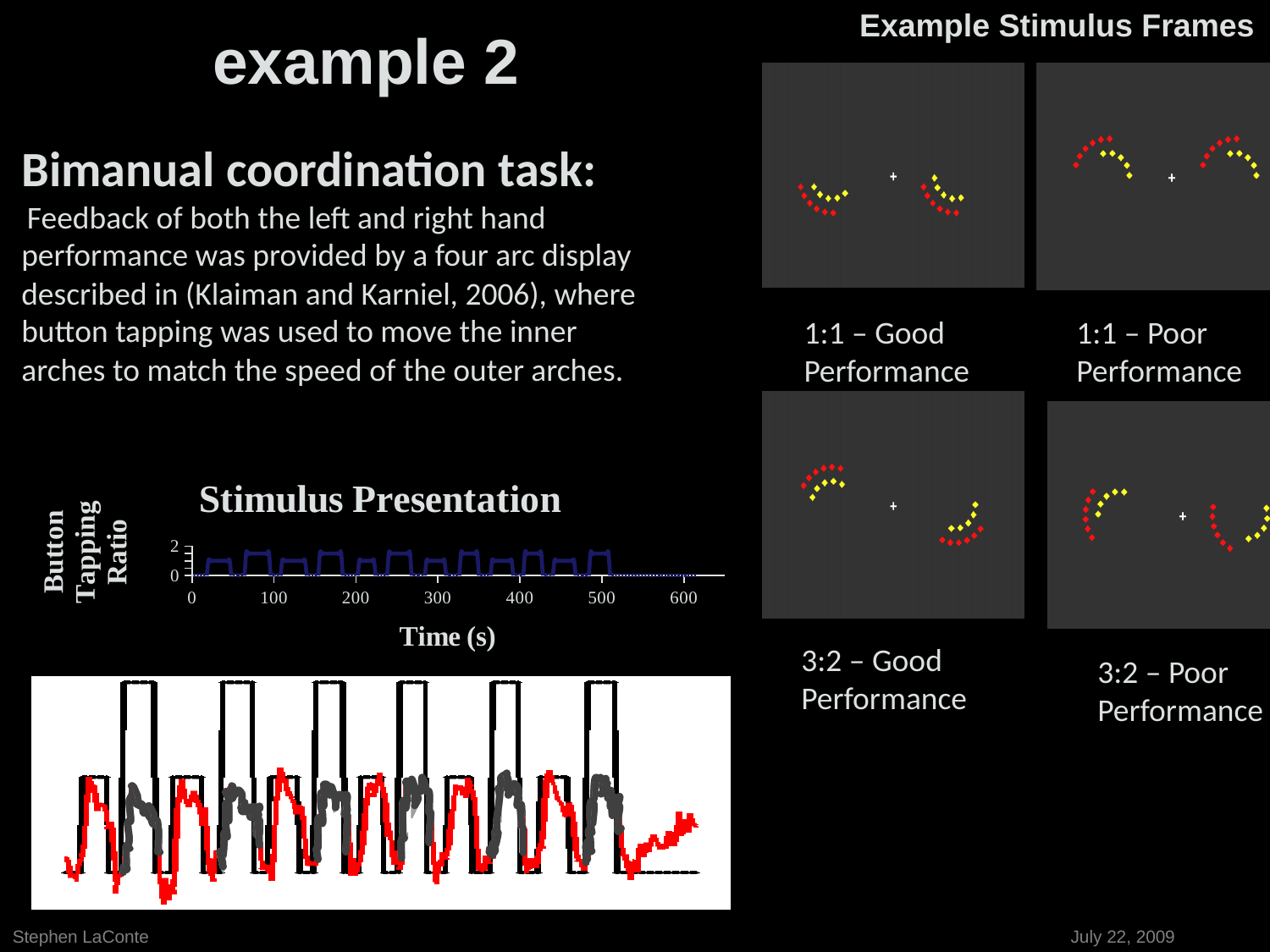
In the "Stimulus Presentation" chart, is the value at time 550 s greater or less than 2? less In the "Stimulus Presentation" chart, is the value at time 550 s greater or less than the value at time 70 s? less What is the label of the y axis on the "Stimulus Presentation" chart? Button Tapping Ratio What is the title of the chart with the Time (s) axis? Stimulus Presentation What kind of chart is the "Stimulus Presentation" chart? line chart